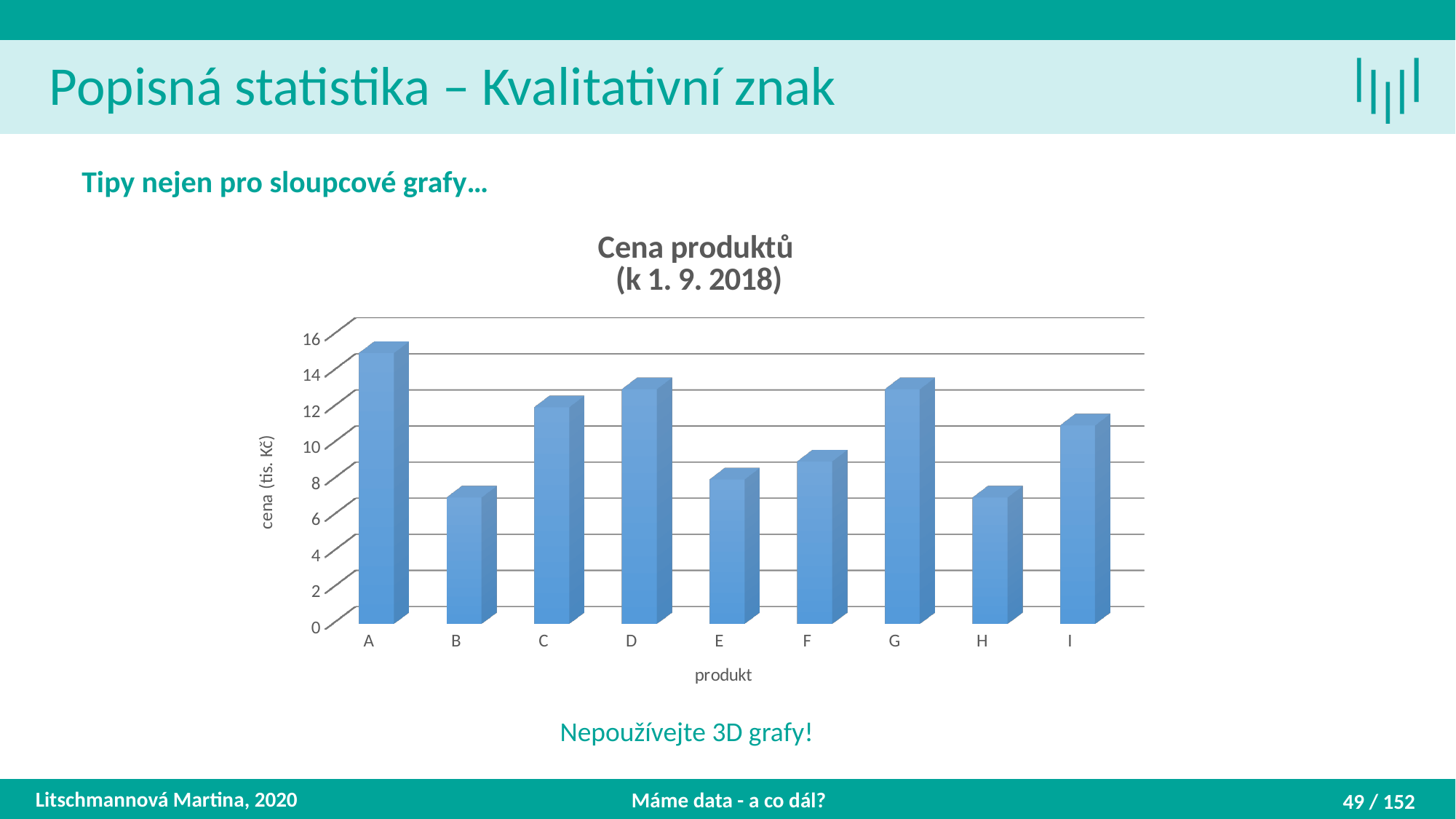
What is the title of the chart? Cena produktů (k 1. 9. 2018) What kind of chart is shown on the slide? bar chart Which has the larger value, product A or product B? A Is the value for product G greater or less than 10? greater Is the value for product A greater or less than 12? greater Is the value for product C greater or less than 10? greater Which product has the highest price in the chart? A Which has the larger value, product H or product I? I How many products are shown on the x axis of the chart? 9 What is the label of the vertical axis of the chart? cena (tis. Kč)